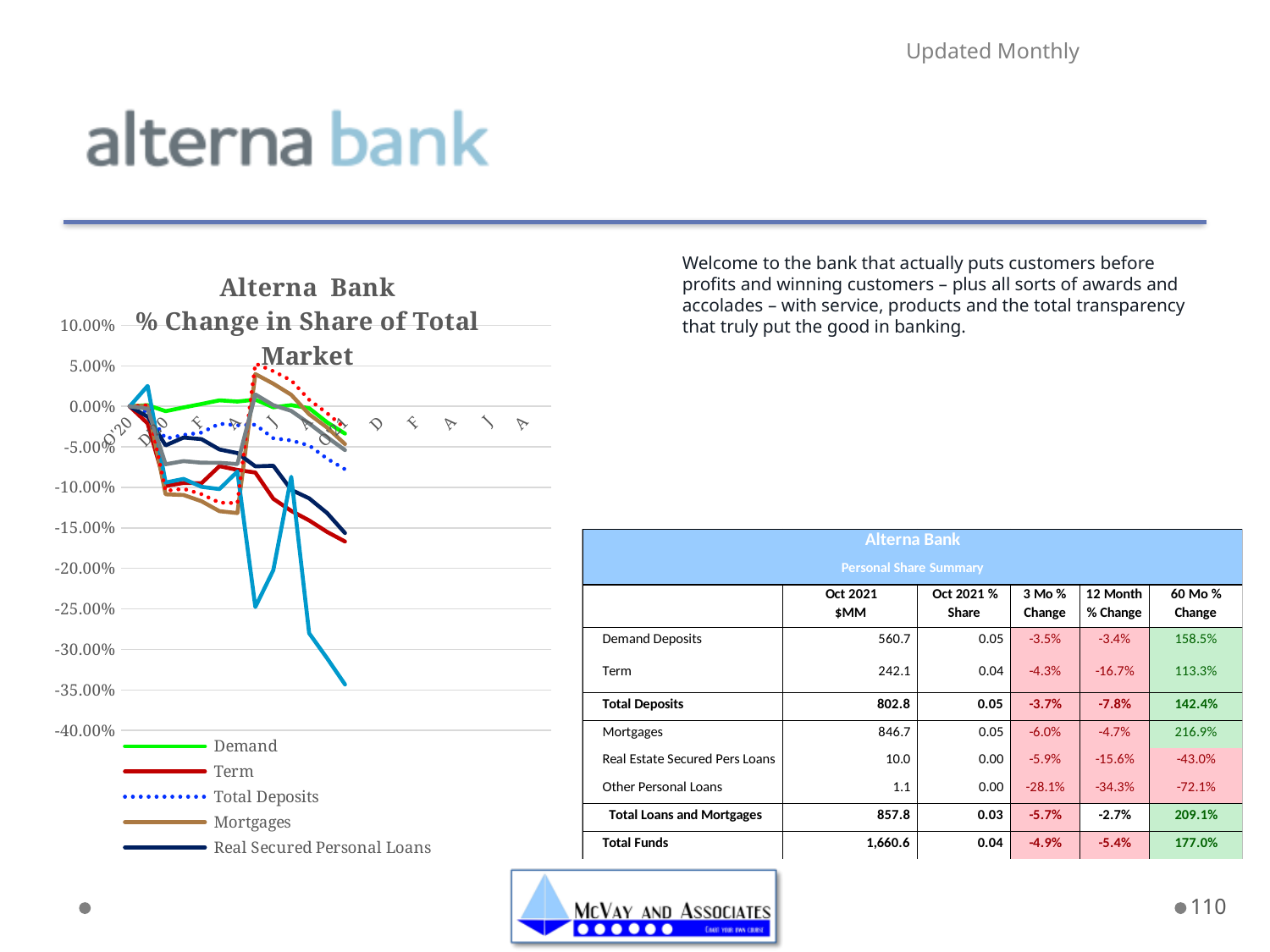
Is the final value of the Term line greater or less than -15.00%? less Does the Term line overall rise or fall from the start to the end of the plotted period? fall At the end of the plotted period, which line is higher: Demand or Term? Demand What is the lowest value shown on the chart's vertical axis? -40.00% How many series does the chart's legend list? 5 Is the lowest point of the Demand line greater or less than -5.00%? greater What kind of chart is shown on the slide? line chart What is the title of the chart on the slide? Alterna Bank % Change in Share of Total Market Is the final value of the Real Secured Personal Loans line greater or less than -10.00%? less What is the highest value shown on the chart's vertical axis? 10.00% Which series is drawn as a dotted line in the chart's legend? Total Deposits